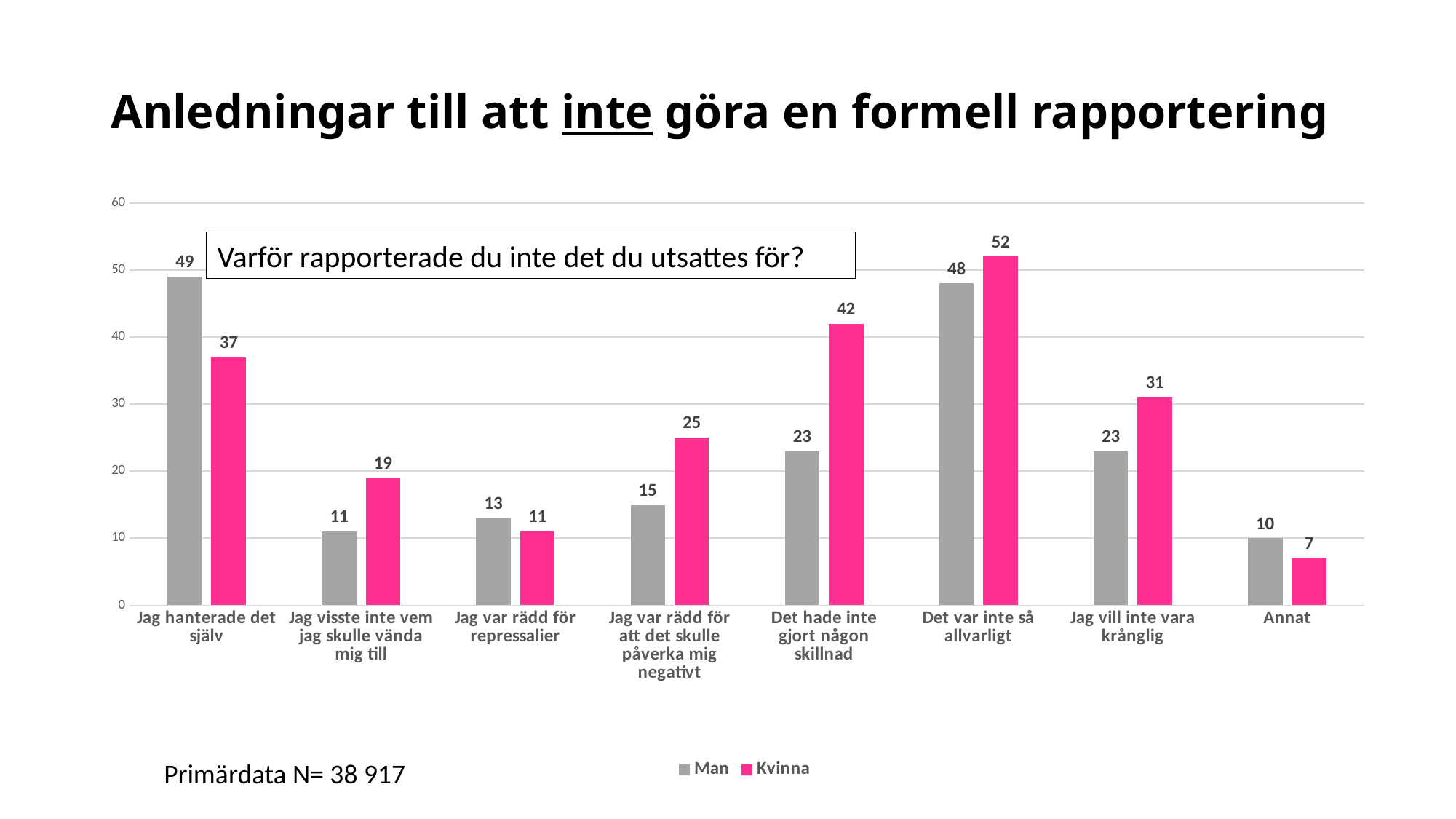
What colour are the bars for the Kvinna series? Pink Which category has the lowest value for Man? Annat What is the value for Kvinna in the category "Det var inte så allvarligt"? 52 What is the value for Man in the category "Jag hanterade det själv"? 49 What is the difference between the Kvinna and Man values for "Det hade inte gjort någon skillnad"? 19 How many series does the legend list? 2 Which category has the lowest value for Kvinna? Annat Which category has the highest value for Kvinna? Det var inte så allvarligt What is the value for Kvinna in the category "Jag vill inte vara krånglig"? 31 What kind of chart is shown on the slide? Bar chart Which is larger for "Jag var rädd för repressalier": the Man value or the Kvinna value? Man How many categories are shown on the x axis? 8